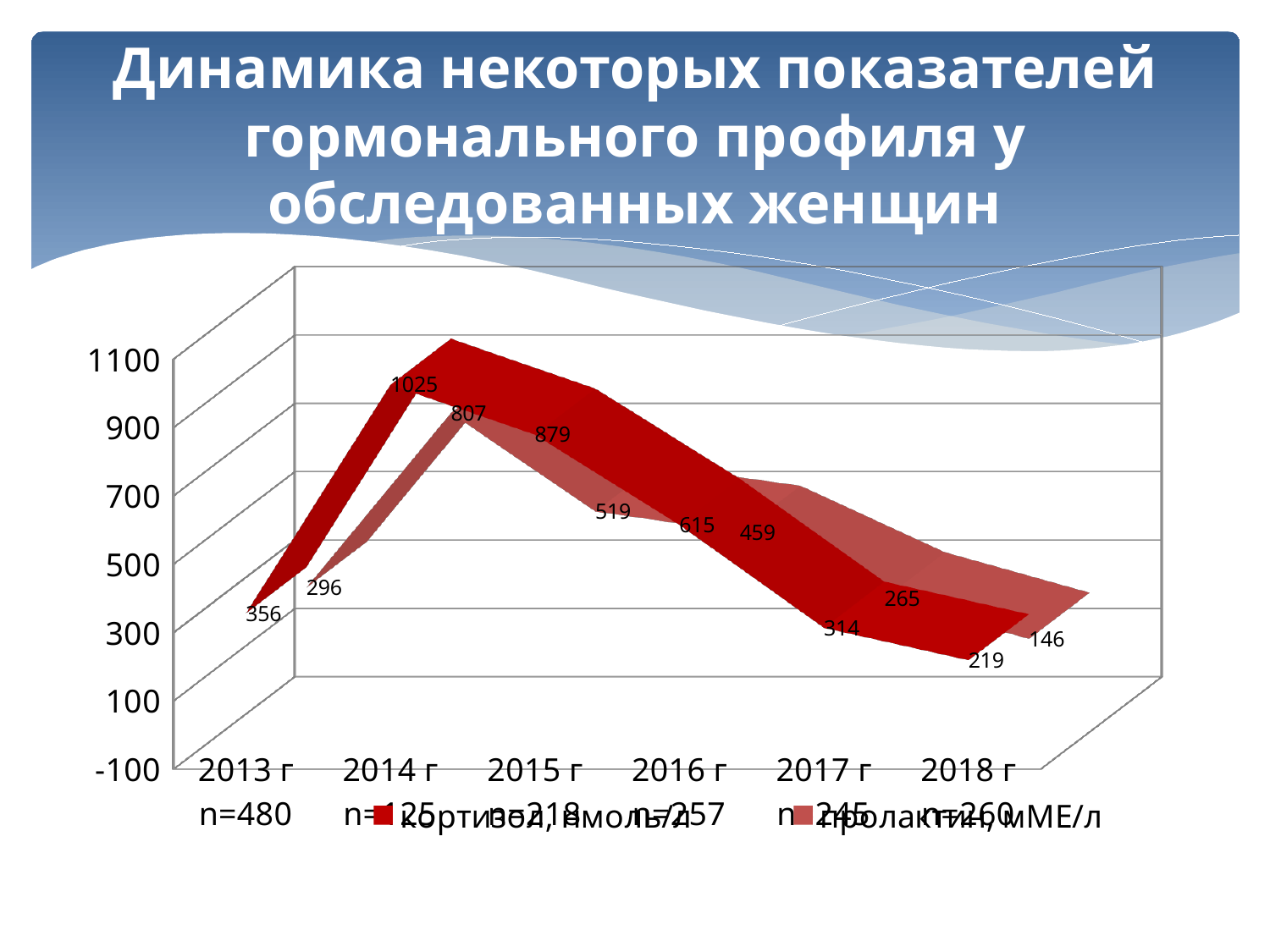
How many years are shown on the x axis of the chart? 6 What is the prolactin (пролактин) value for 2015 г? 519 How do the cortisol (кортизол) values change from 2014 г to 2018 г? they fall How many series does the chart legend list? 2 What is the cortisol (кортизол) value for 2014 г? 1025 What is the cortisol (кортизол) value for 2016 г? 615 In which year is the cortisol (кортизол) value highest? 2014 г What is the prolactin (пролактин) value for 2018 г? 146 What type of chart is shown on the slide? 3D line chart What is the difference between the cortisol (кортизол) values for 2014 г and 2015 г? 146 Which is larger in 2017 г: the cortisol (кортизол) value or the prolactin (пролактин) value? cortisol (кортизол) In which year is the prolactin (пролактин) value lowest? 2018 г